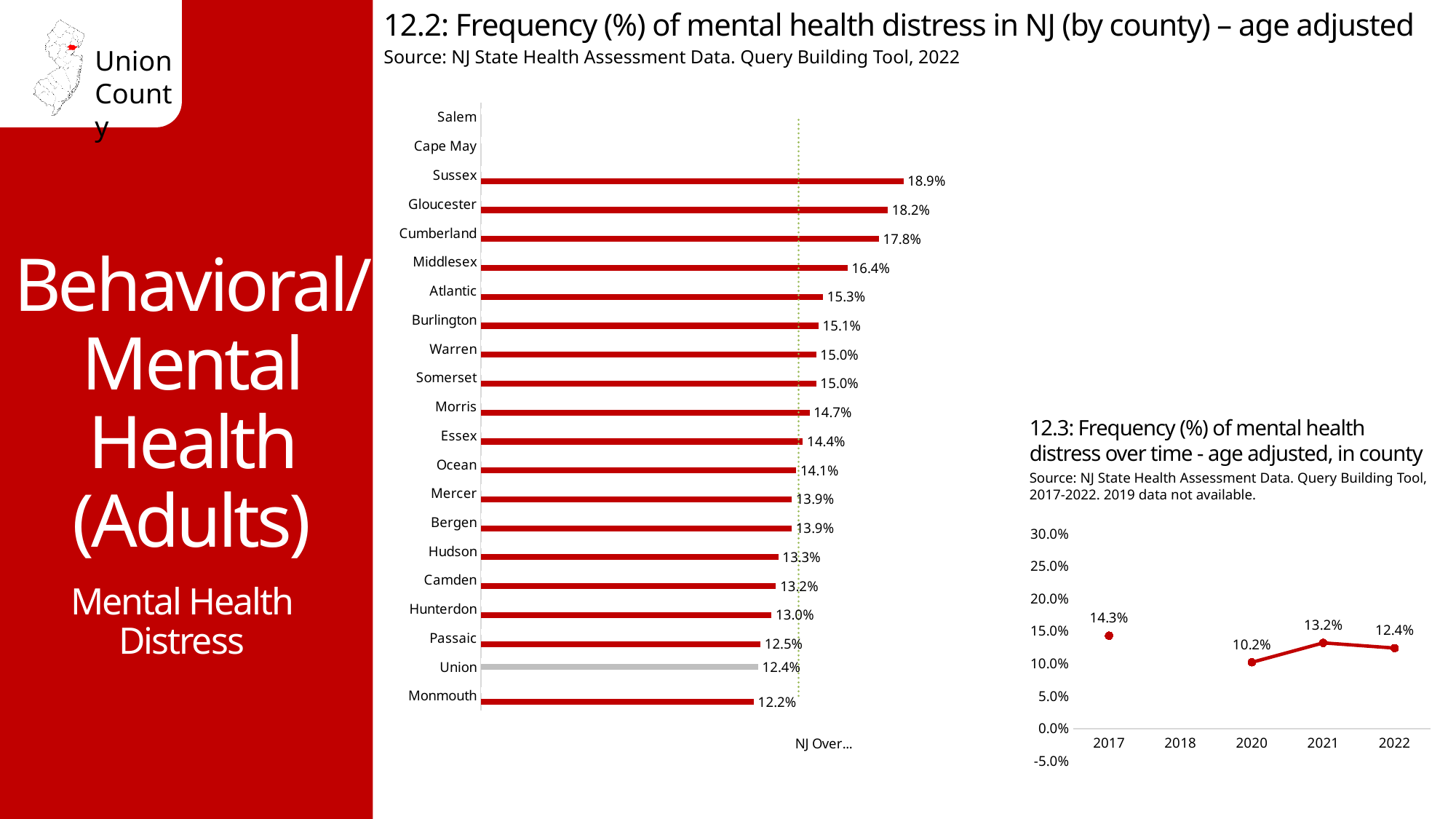
In chart 12.3 (frequency of mental health distress over time), what is the value for 2020? 10.2% In chart 12.3 (frequency of mental health distress over time), what is the difference between 2021 and 2022? 0.8% In chart 12.3 (frequency of mental health distress over time), how many data points are plotted? 4 In chart 12.2 (frequency of mental health distress by county), what is the value for Hunterdon? 13.0% In chart 12.2 (frequency of mental health distress by county), what is the value for Union? 12.4% In chart 12.2 (frequency of mental health distress by county), which is larger, Middlesex or Atlantic? Middlesex In chart 12.2 (frequency of mental health distress by county), what is the difference between Gloucester and Cumberland? 0.4% What kind of chart is chart 12.2 (frequency of mental health distress by county)? Bar chart In chart 12.2 (frequency of mental health distress by county), which county with a plotted bar has the lowest value? Monmouth In chart 12.2 (frequency of mental health distress by county), which county has the highest value? Sussex In chart 12.3 (frequency of mental health distress over time), which year has the highest value? 2017 In chart 12.2 (frequency of mental health distress by county), what is the value for Sussex? 18.9%